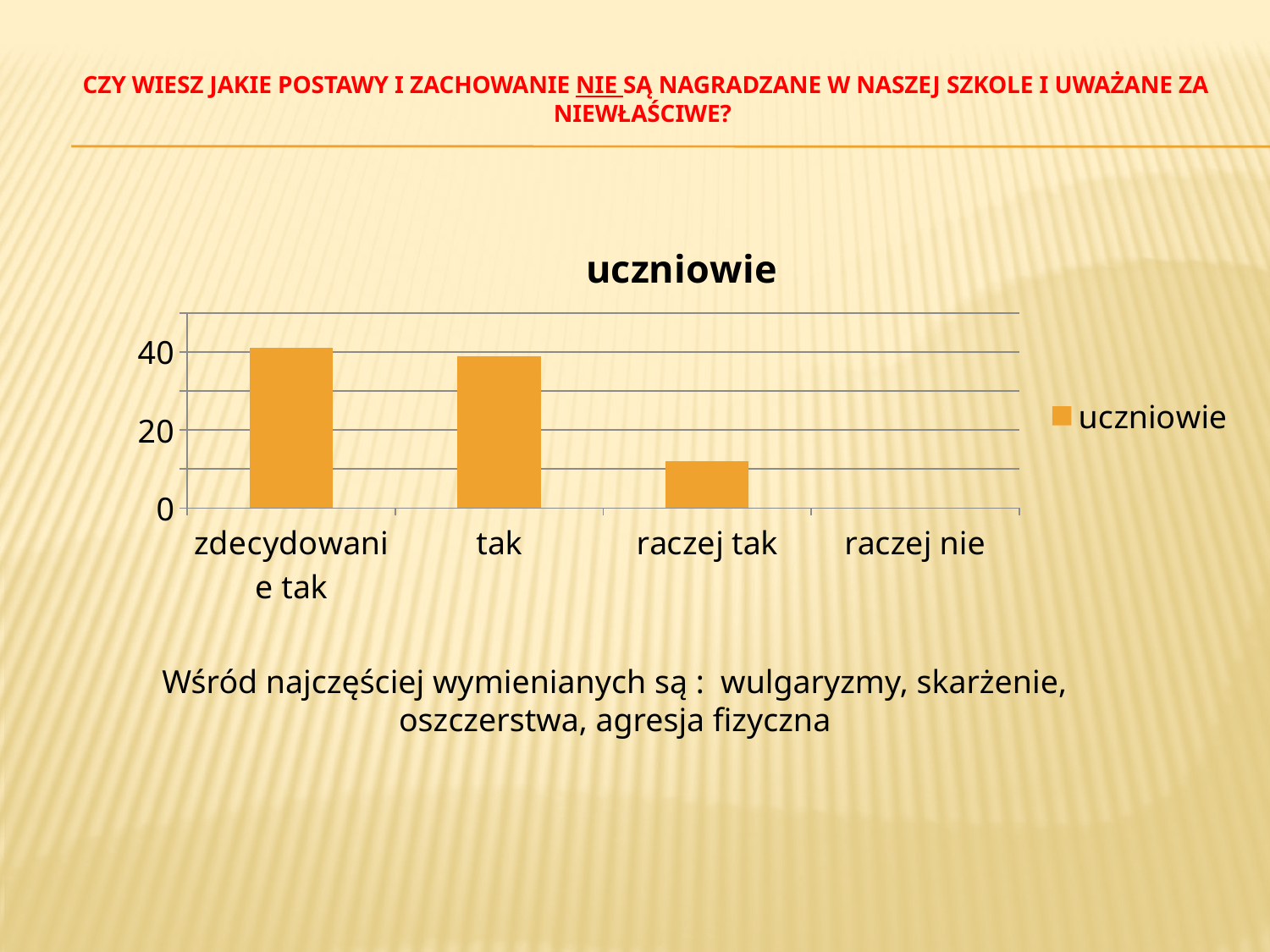
What is the title of the chart? uczniowie Is the value for raczej tak greater or less than 20? less What is the value for raczej nie? 0 How many series does the legend list? 1 Which is larger, the value for zdecydowanie tak or the value for raczej nie? zdecydowanie tak Do the values rise or fall moving from left to right along the x axis? fall Is the value for tak greater or less than 20? greater Is the value for zdecydowanie tak greater or less than 20? greater How many categories are shown on the x axis of the chart? 4 What kind of chart is shown on the slide? bar chart Which is larger, the value for tak or the value for raczej tak? tak Which category has the lowest value in the chart? raczej nie